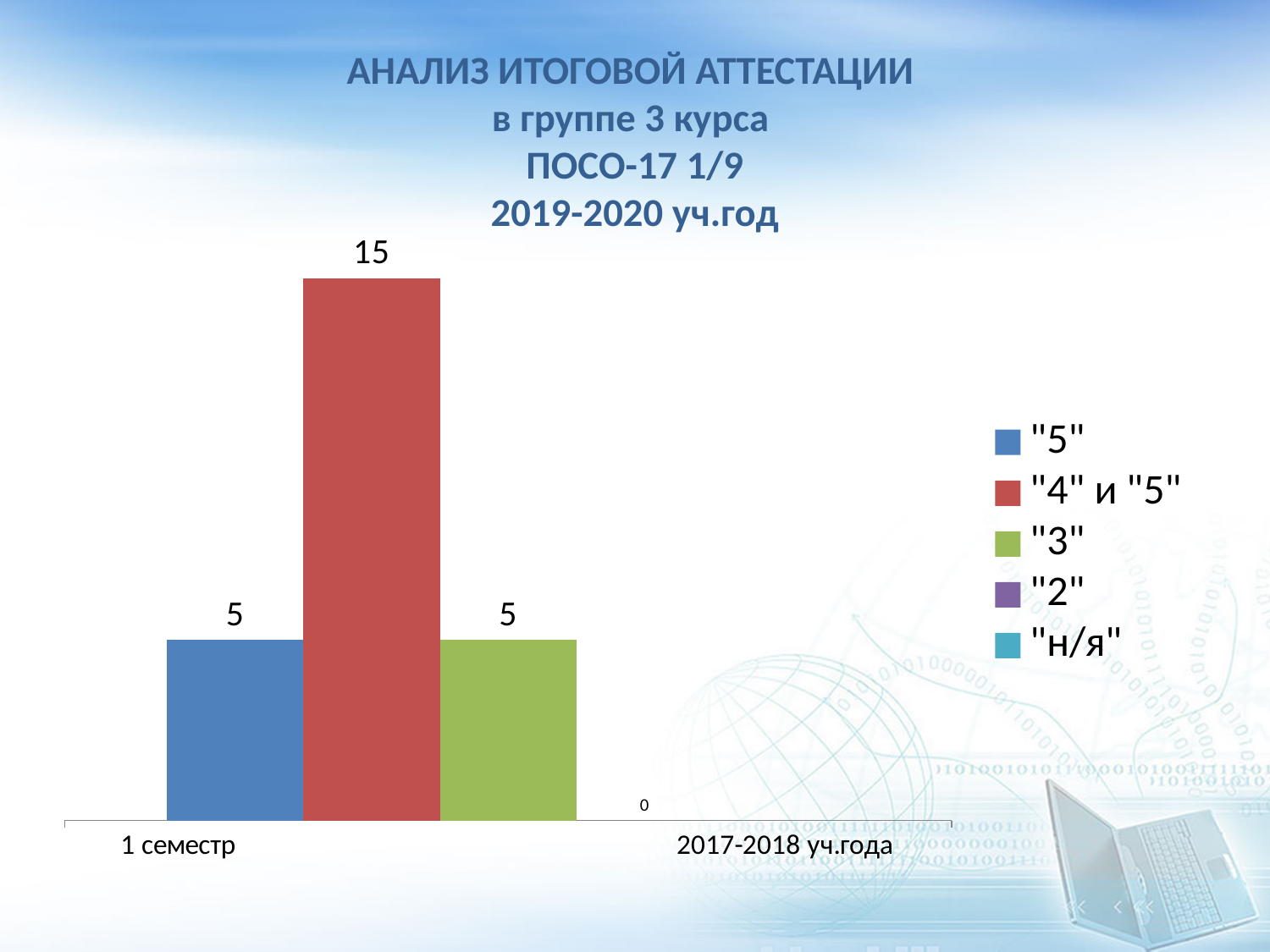
What is the last legend entry? "н/я" What is the value for the "3" series in 1 семестр? 5 What is the difference between the "4" и "5" value and the "5" value in 1 семестр? 10 What colour is the bar for the "4" и "5" series? red What type of chart is shown on the slide? bar chart Which is larger in 1 семестр: the "4" и "5" value or the "3" value? "4" и "5" How many series does the legend list? 5 What is the value for the "5" series in 1 семестр? 5 What is the value for the "4" и "5" series in 1 семестр? 15 Which series has the highest value in 1 семестр? "4" и "5" How many categories are shown on the x axis? 1